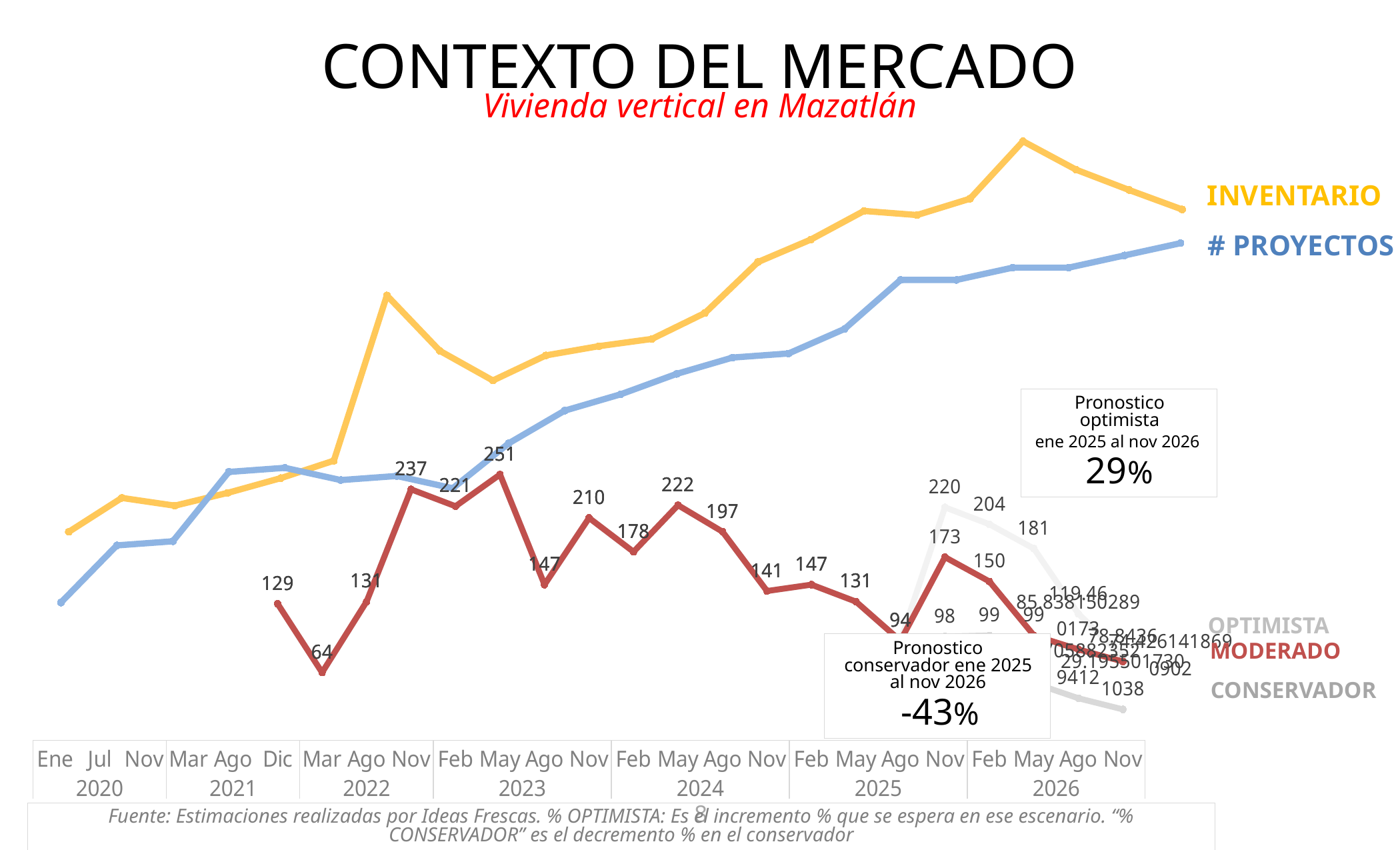
At the right end of the chart (Nov 2026), which line is higher: INVENTARIO or # PROYECTOS? INVENTARIO What is the red subtitle under the chart title? Vivienda vertical en Mazatlán What type of chart is shown on the slide? line chart What is the lowest data label shown on the MODERADO line? 64 Which series is drawn in yellow? INVENTARIO How many series does the chart's legend list? 5 What is the first data label shown on the MODERADO line? 129 What percentage is given for the 'Pronostico conservador ene 2025 al nov 2026'? -43% What is the highest data label shown on the MODERADO line? 251 Does the # PROYECTOS line generally rise or fall from 2020 to 2026? rise What percentage is given for the 'Pronostico optimista ene 2025 al nov 2026'? 29% What is the difference between the highest (251) and lowest (64) data labels on the MODERADO line? 187